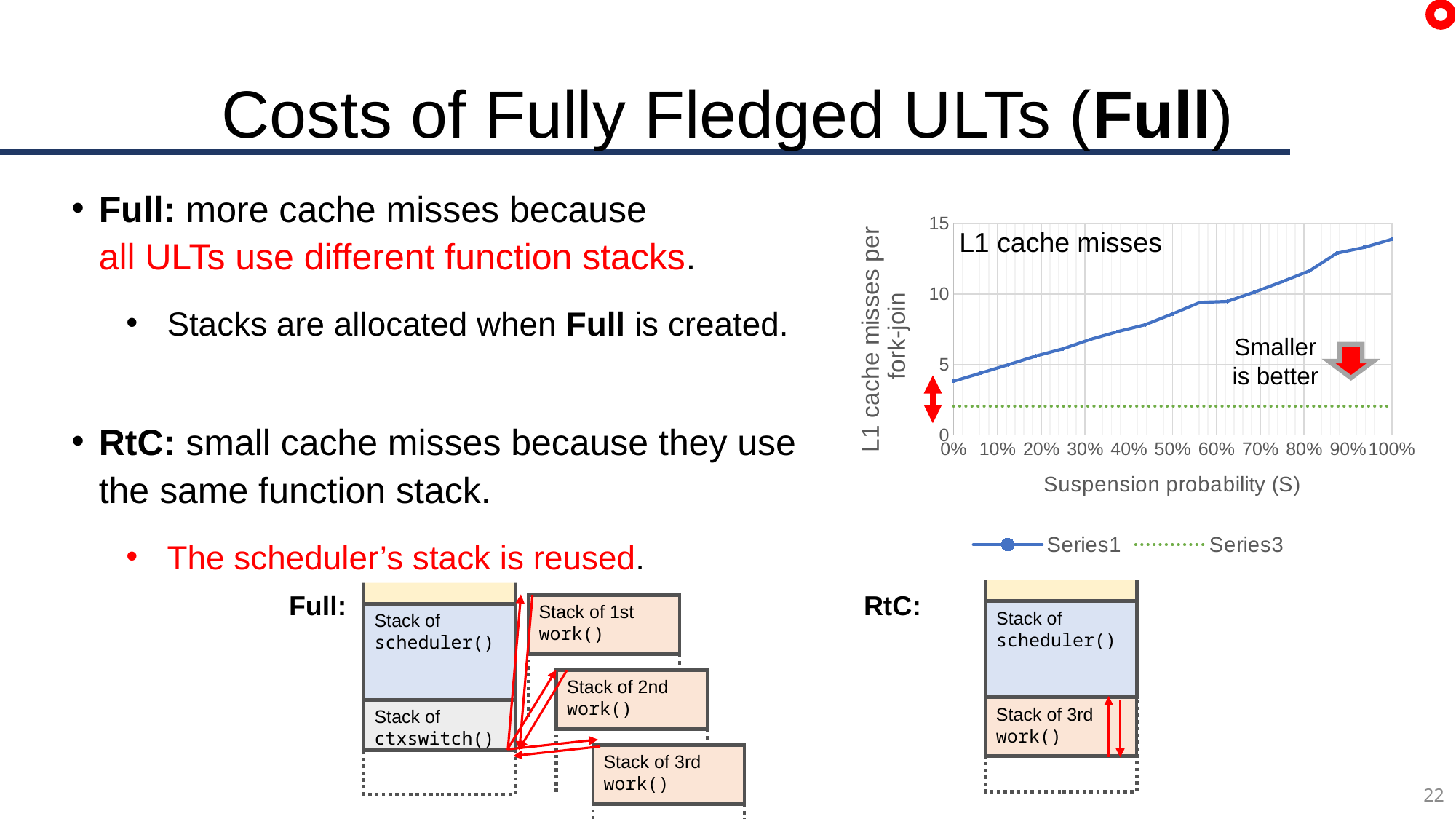
How many suspension probability tick labels are shown on the x axis? 11 Is the value of Series1 at 0% suspension probability greater or less than 5? less What kind of chart is shown on the slide? line chart At 80% suspension probability, which series has the larger value, Series1 or Series3? Series1 What is the x-axis title of the chart? Suspension probability (S) Is the value of Series3 at 50% suspension probability greater or less than 5? less How many series does the chart legend list? 2 Is the value of Series1 at 50% suspension probability greater or less than 5? greater Does Series1 rise or fall as the suspension probability increases from 0% to 100%? rise What are the names of the series listed in the chart legend? Series1 and Series3